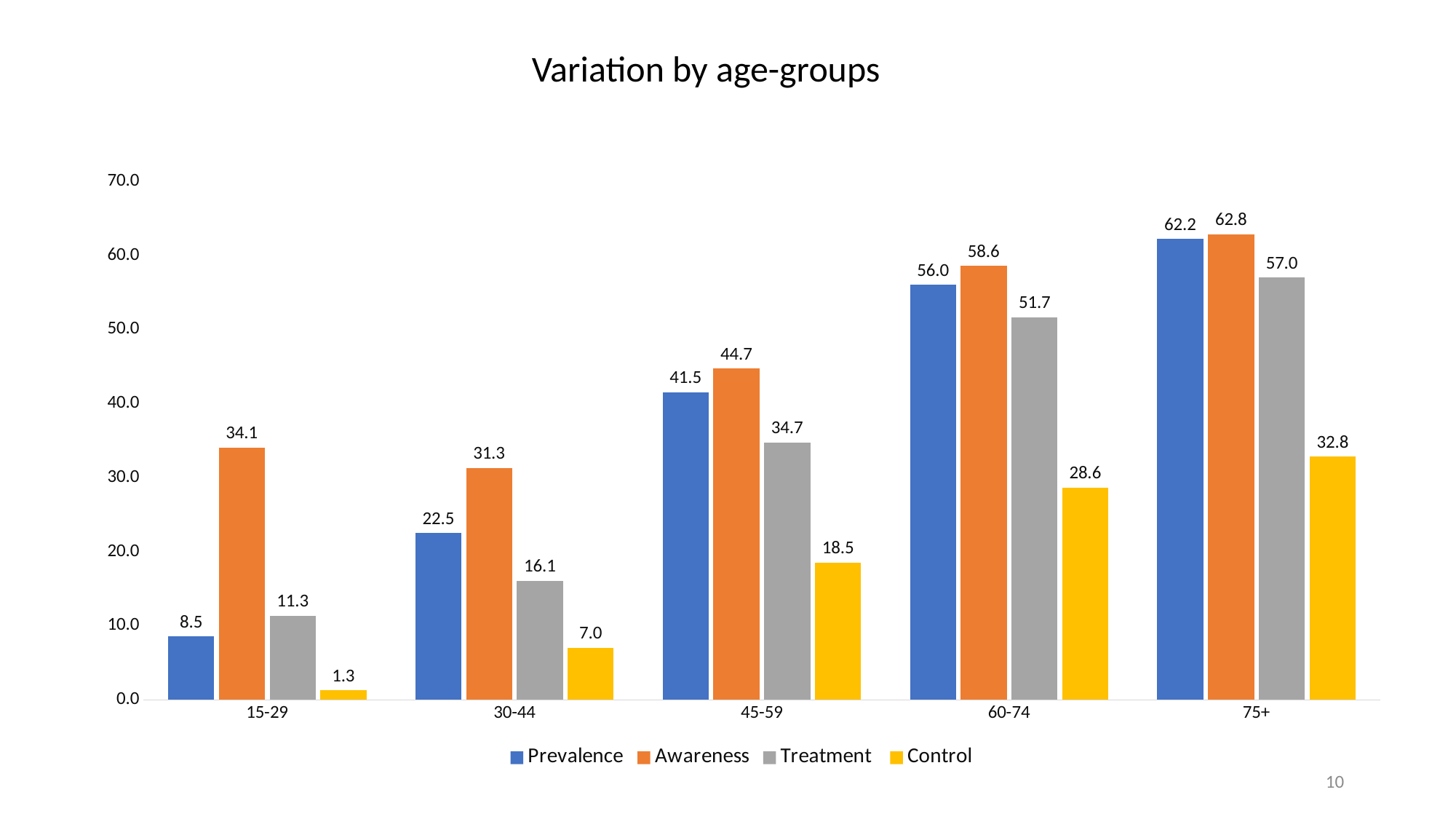
Which age group has the lowest Prevalence value? 15-29 What kind of chart is shown on the slide? Bar chart Do the Prevalence values rise or fall as age group increases along the x axis? Rise Which age group has the highest Awareness value? 75+ How many age groups are shown on the x axis? 5 What is the difference between the Awareness and Treatment values for the 30-44 age group? 15.2 Which is larger for the 60-74 age group, Prevalence or Control? Prevalence What is the Control value for the 15-29 age group? 1.3 What is the Treatment value for the 60-74 age group? 51.7 How many series does the legend list? 4 What is the Prevalence value for the 45-59 age group? 41.5 Is the Control value for the 75+ age group greater or less than 30.0? greater